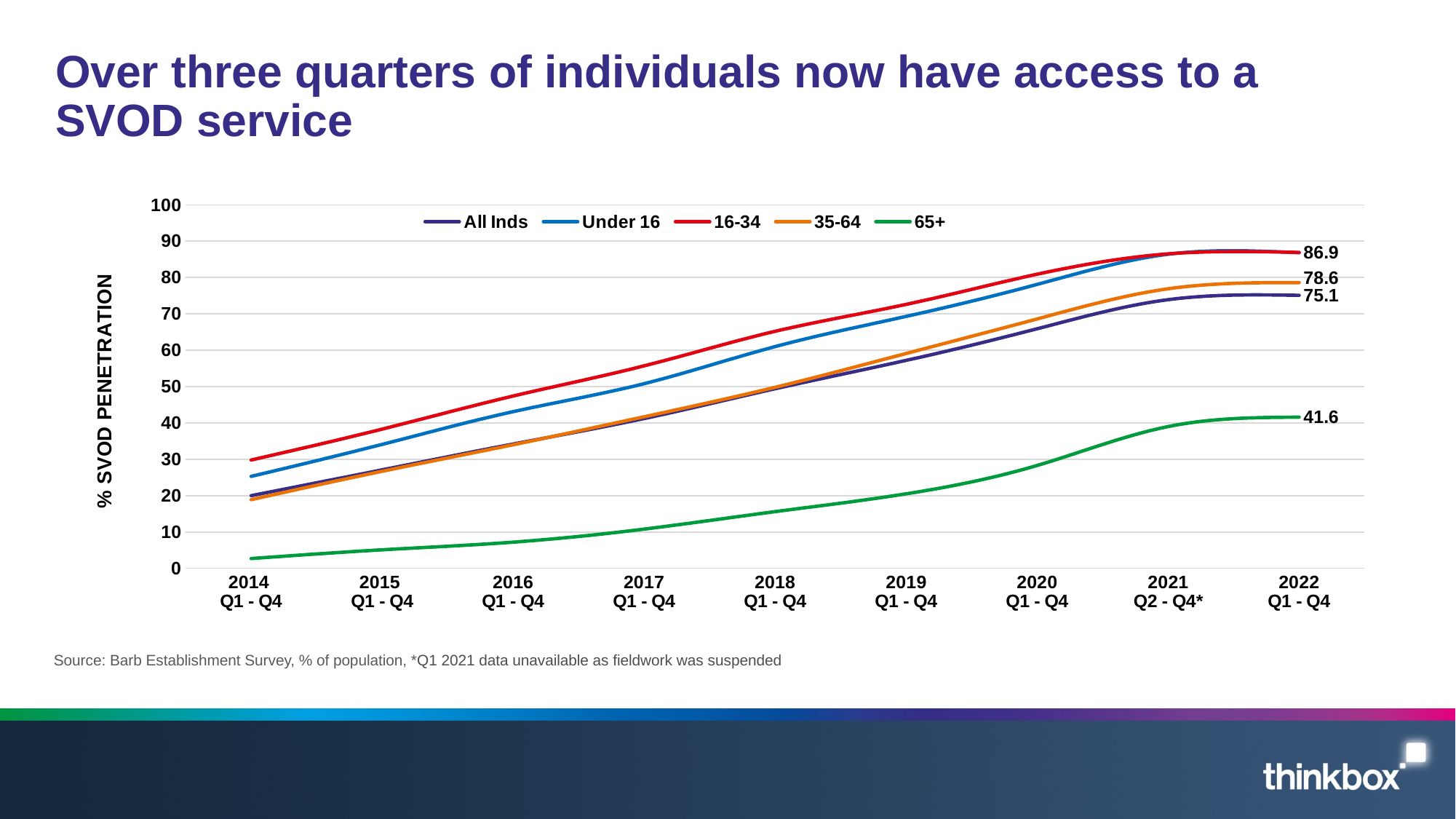
What kind of chart is shown on the slide? line chart What is the y-axis title of the chart? % SVOD PENETRATION What is the value for 35-64 in 2022 Q1 - Q4? 78.6 What is the value for All Inds in 2022 Q1 - Q4? 75.1 What is the value for 65+ in 2022 Q1 - Q4? 41.6 Is the value for 65+ in 2014 Q1 - Q4 greater or less than 10? less How many time periods are shown along the x axis? 9 What is the difference between the 35-64 and All Inds values in 2022 Q1 - Q4? 3.5 How many series does the legend list? 5 Does the 65+ line rise or fall from 2014 to 2022? rise What is the difference between the All Inds and 65+ values in 2022 Q1 - Q4? 33.5 Which series has the lowest value in 2022 Q1 - Q4? 65+